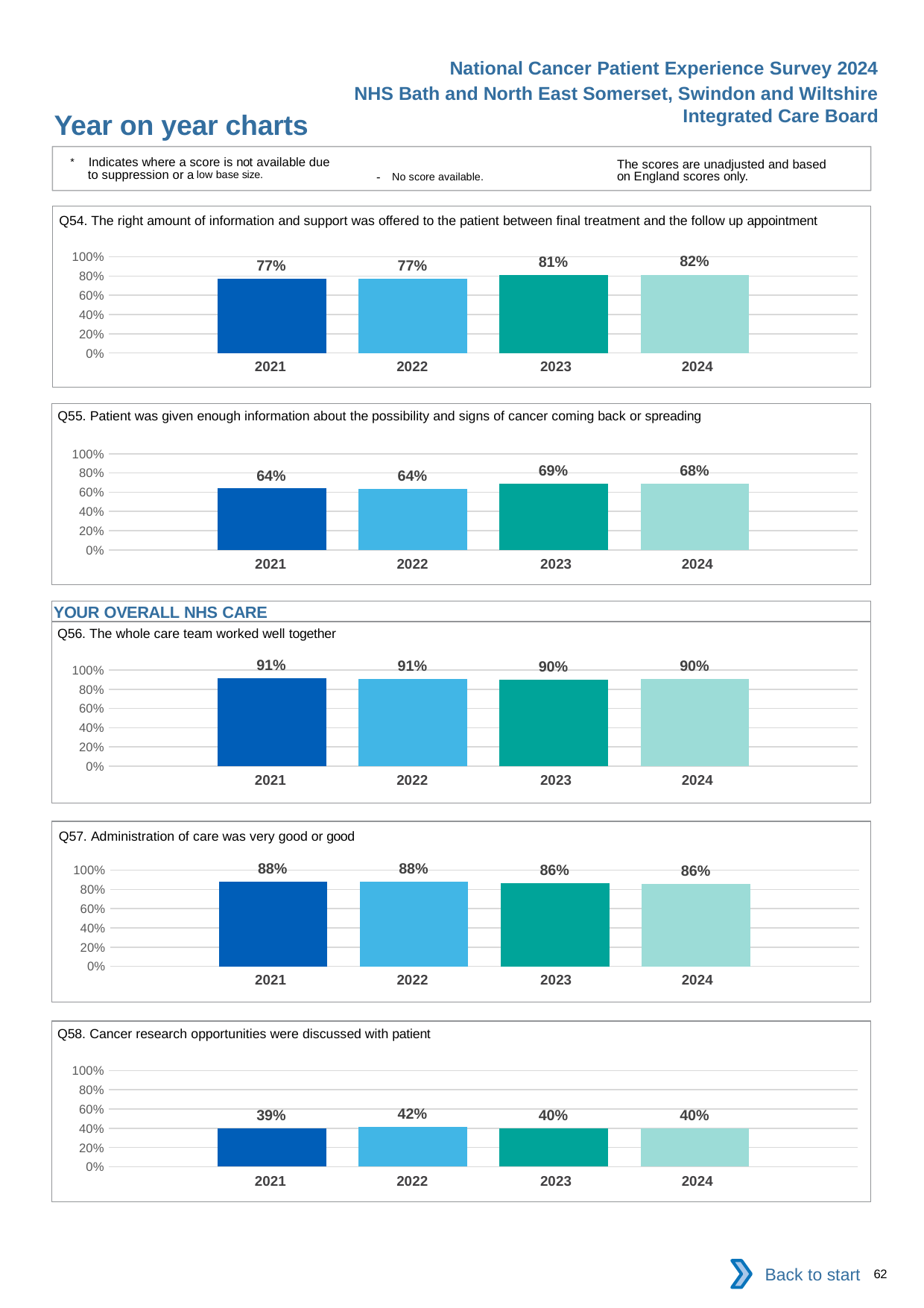
In the Q58 chart, which year has the highest value? 2022 In the Q56 chart, what is the value for 2021? 91% In the Q54 chart, what is the value for 2024? 82% In the Q54 chart, which year has the lowest value? 2021 and 2022 (both 77%) In the Q57 chart, what is the value for 2024? 86% In the Q57 chart, is the 2021 value larger or smaller than the 2023 value? larger In the Q55 chart, what is the difference between the 2023 and 2021 values? 5 percentage points In the Q58 chart, is the value for 2021 greater or less than 60%? less What kind of chart is the Q58 chart? bar chart In the Q55 chart, which year has the highest value? 2023 In the Q55 chart, what is the value for 2023? 69% In the Q56 chart, how many years are plotted? 4